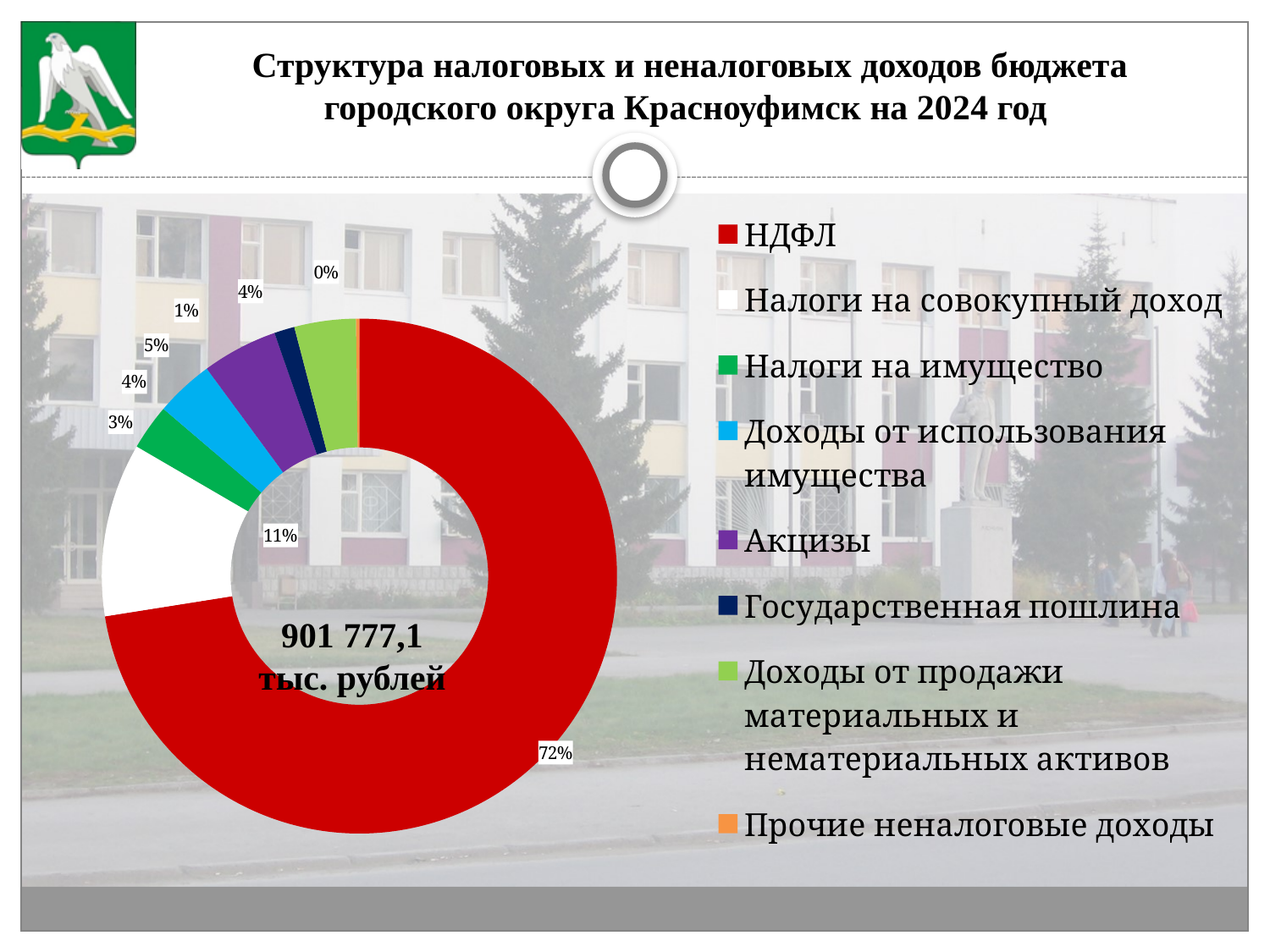
What share is shown for Налоги на совокупный доход? 11% What share is shown for Акцизы? 5% What share is shown for Налоги на имущество? 3% What kind of chart is shown on the slide? Pie (doughnut) chart How many categories does the legend list? 8 Which category has the smallest share of the chart? Прочие неналоговые доходы What total amount is printed in the centre of the chart? 901 777,1 тыс. рублей What share of the chart does НДФЛ account for? 72% Which category has the largest share of the chart? НДФЛ What share is shown for Государственная пошлина? 1% What is the difference between the shares of НДФЛ and Налоги на совокупный доход? 61% Which is larger, the share of Акцизы or the share of Налоги на имущество? Акцизы